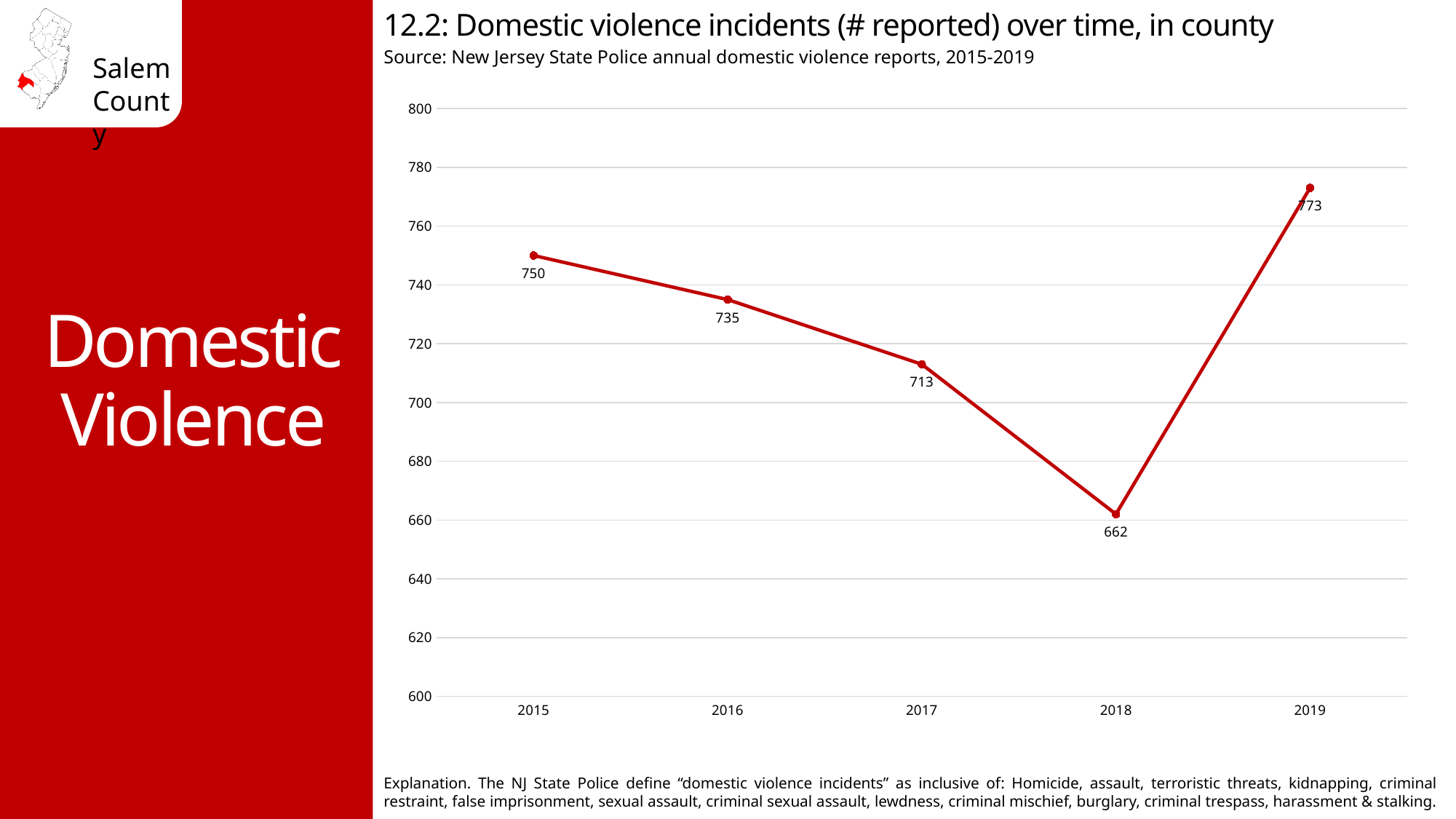
How many years are plotted on the chart? 5 By how much did reported incidents fall from 2015 to 2016? 15 Which year has the highest number of reported domestic violence incidents? 2019 What is the number of reported domestic violence incidents for 2018? 662 What value is shown for 2017? 713 What kind of chart is shown on the slide? line chart Did the number of reported incidents rise or fall from 2015 to 2018? fall Which year has the lowest number of reported domestic violence incidents? 2018 What is the difference between the number of incidents in 2019 and 2018? 111 Which year had more reported incidents, 2016 or 2017? 2016 How many domestic violence incidents were reported in 2015? 750 Is the value for 2018 greater or less than 680? less